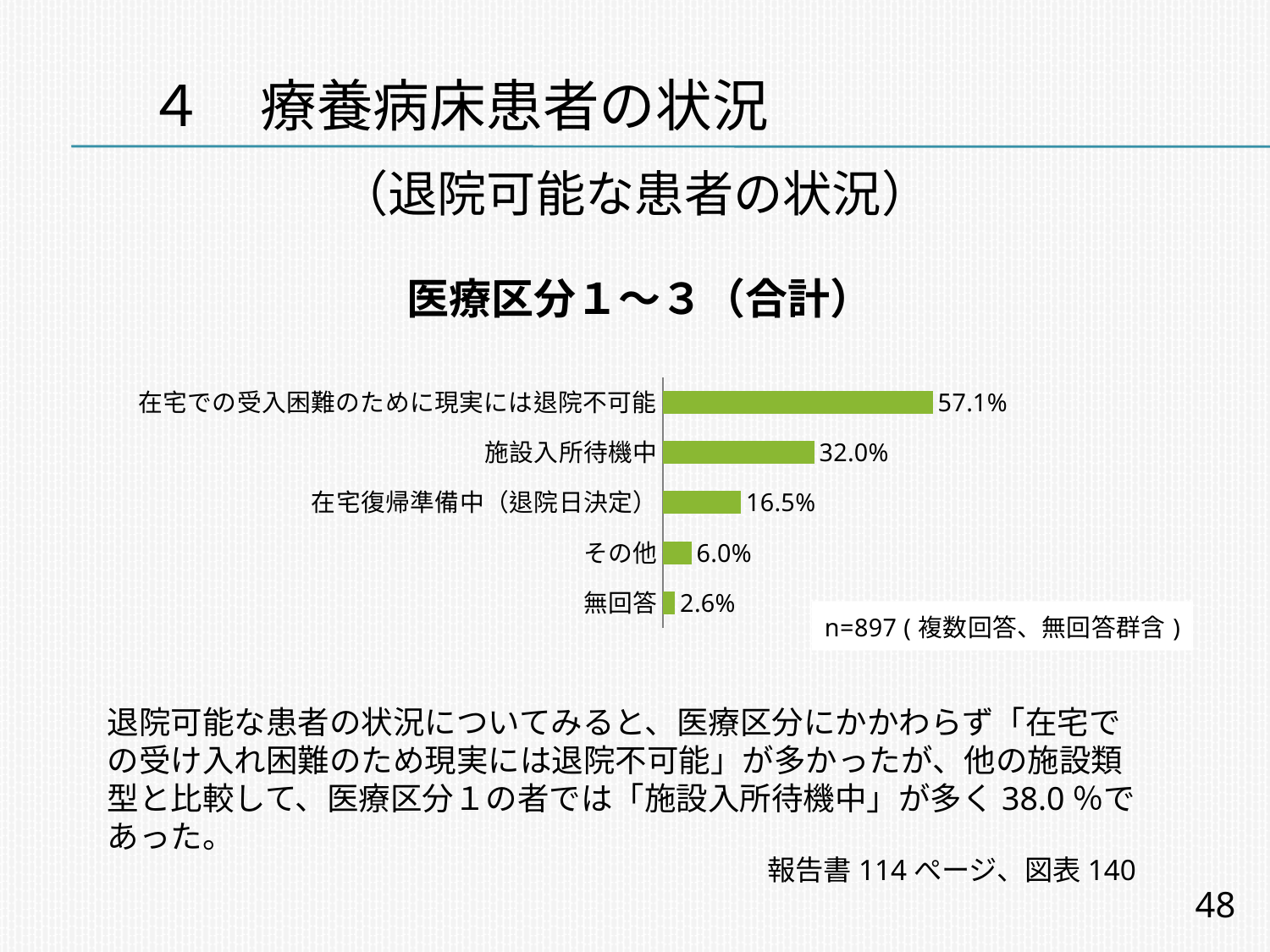
What is the difference between the values for 在宅での受入困難のために現実には退院不可能 and 施設入所待機中? 25.1% What is the title of the chart? 医療区分１～３（合計） What is the value for その他? 6.0% What is the value for 無回答? 2.6% Which category has the lowest value? 無回答 What kind of chart is shown on the slide? Bar chart Which category has the highest value? 在宅での受入困難のために現実には退院不可能 What is the value for 在宅での受入困難のために現実には退院不可能? 57.1% What is the value for 在宅復帰準備中（退院日決定）? 16.5% How many categories are shown in the chart? 5 Which is larger, the value for 在宅復帰準備中（退院日決定） or the value for その他? 在宅復帰準備中（退院日決定） What is the value for 施設入所待機中? 32.0%